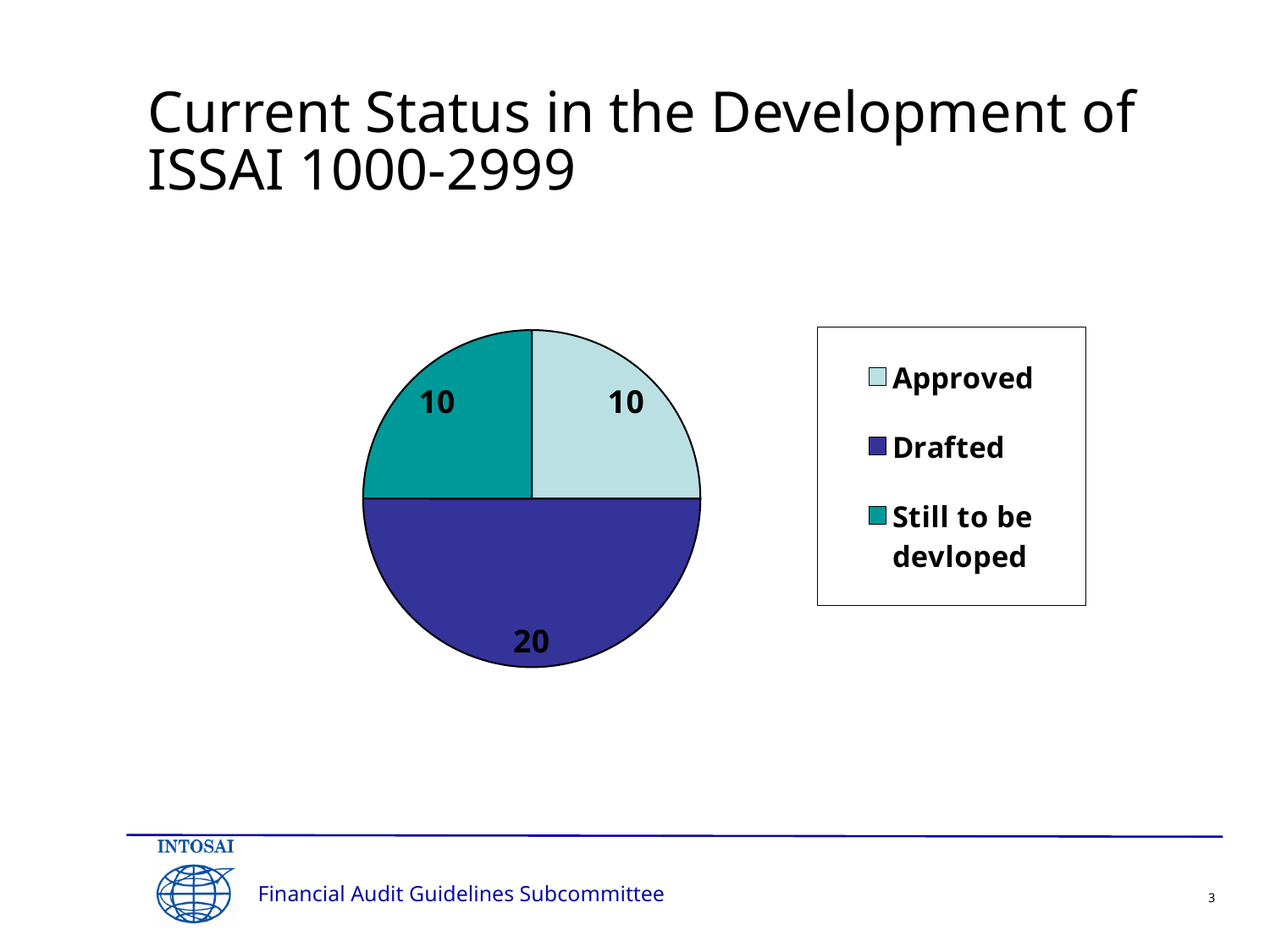
How many entries does the legend list? 3 What type of chart is shown on the slide? pie chart Which is larger, the value for Drafted or the value for Still to be devloped? Drafted What share of the pie does the Drafted slice represent? 50% What share of the pie does the Approved slice represent? 25% What is the value for Still to be devloped? 10 What is the value for Drafted? 20 How many slices does the pie chart have? 3 Which category has the largest slice? Drafted What is the difference between the Drafted value and the Approved value? 10 What is the total of all slices in the pie chart? 40 What is the value for Approved? 10